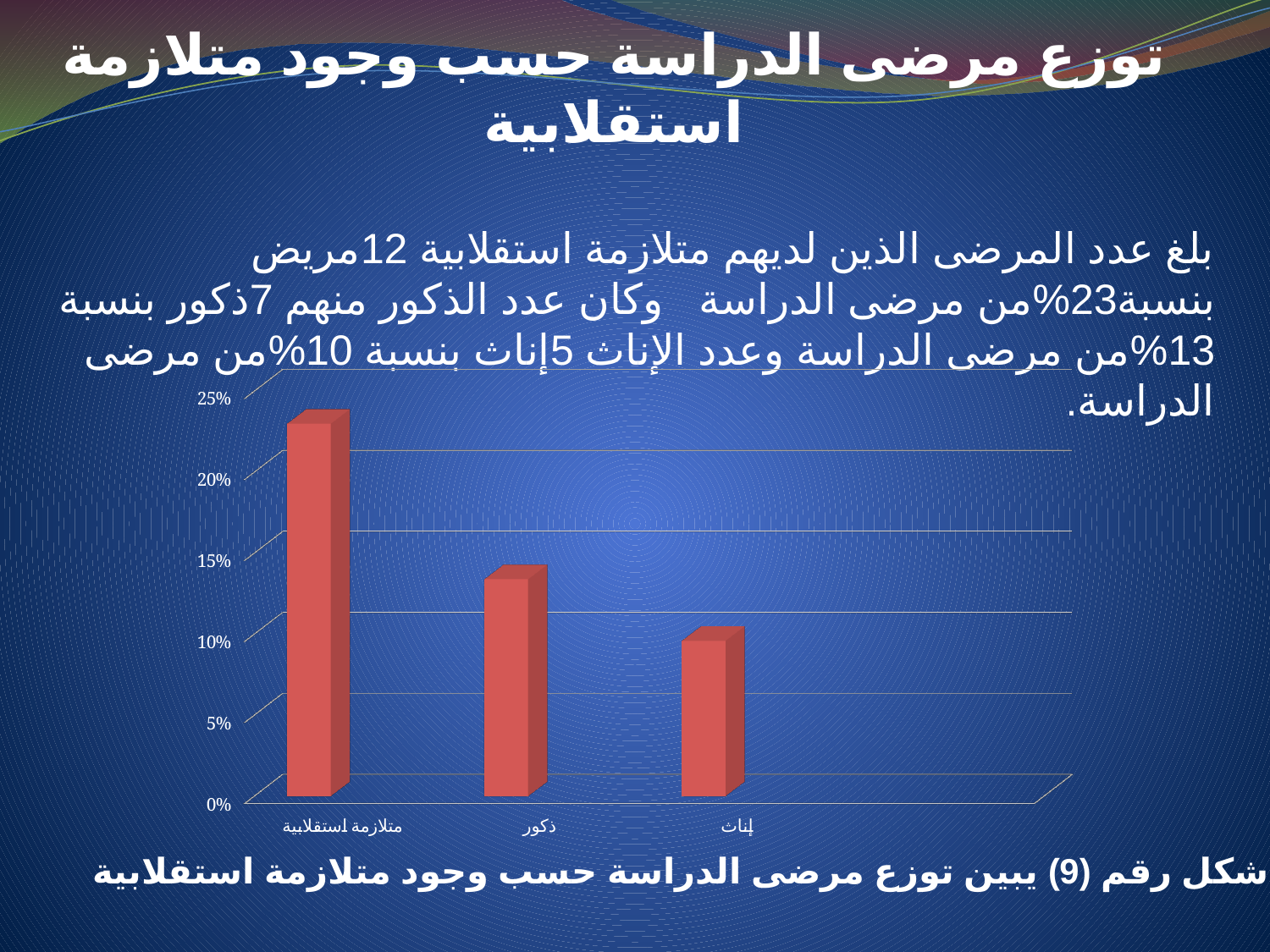
Is the value for ذكور greater or less than 10%? greater How many categories are shown on the x axis of the chart? 3 What is the figure number given in the caption below the chart? 9 What kind of chart is shown on the slide? bar chart What is the highest value shown on the vertical axis of the chart? 25% Is the value for ذكور greater or less than 15%? less Which category has the lowest bar in the chart? إناث Which category has the highest bar in the chart? متلازمة استقلابية Is the value for متلازمة استقلابية greater or less than 20%? greater Do the bar values rise or fall from left to right along the x axis? fall Which is larger, the value for ذكور or the value for إناث? ذكور